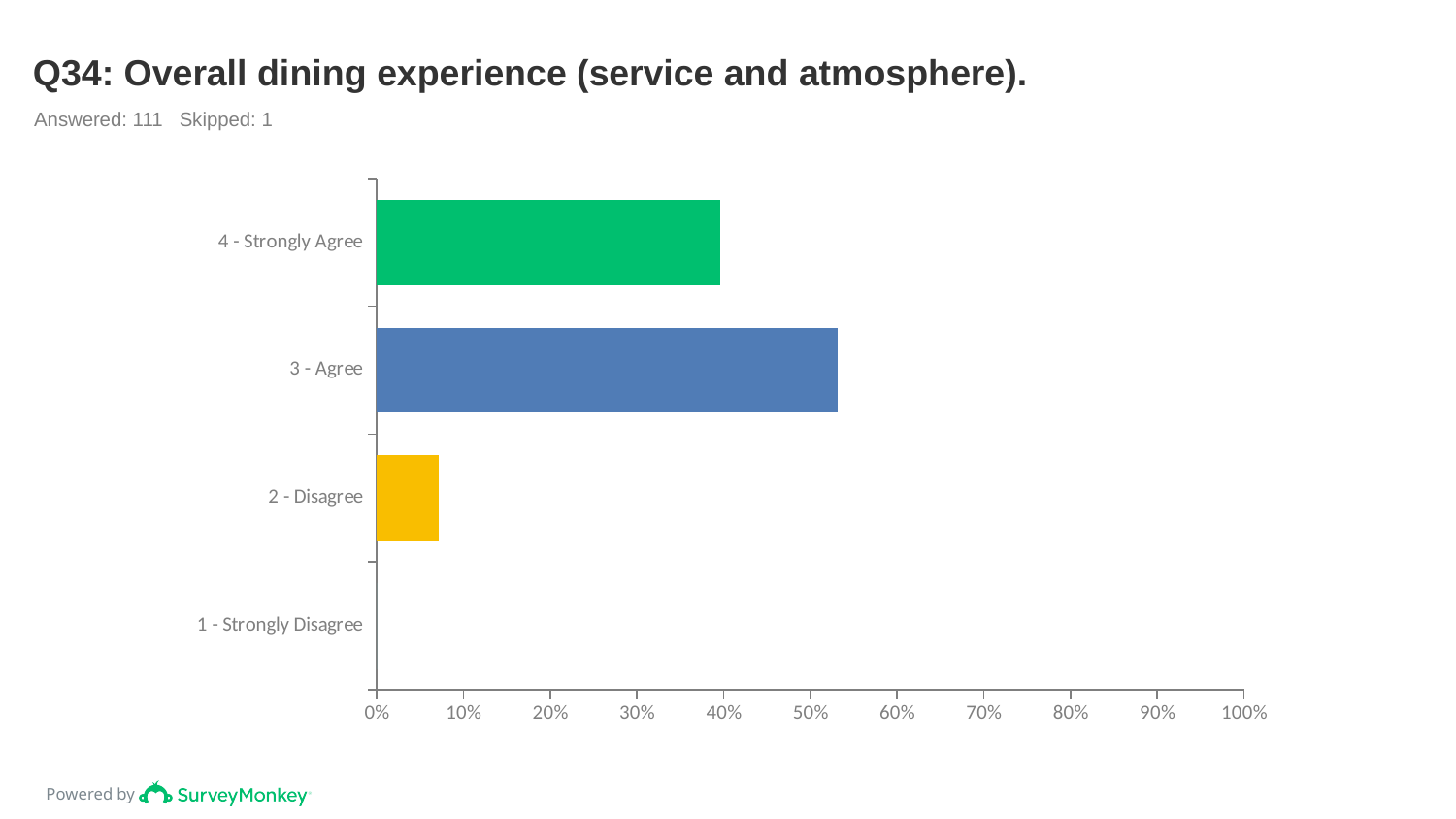
Is the value for 4 - Strongly Agree greater or less than 50%? less Which is larger, the value for 4 - Strongly Agree or the value for 3 - Agree? 3 - Agree How many response categories are plotted on the chart? 4 Is the value for 2 - Disagree greater or less than 10%? less Which response category has the lowest value? 1 - Strongly Disagree What kind of chart is shown on the slide? Bar chart What is the title of the chart? Q34: Overall dining experience (service and atmosphere). Is the value for 3 - Agree greater or less than 50%? greater Which is larger, the value for 2 - Disagree or the value for 4 - Strongly Agree? 4 - Strongly Agree How many respondents answered the question according to the slide? 111 Which response category has the highest value? 3 - Agree